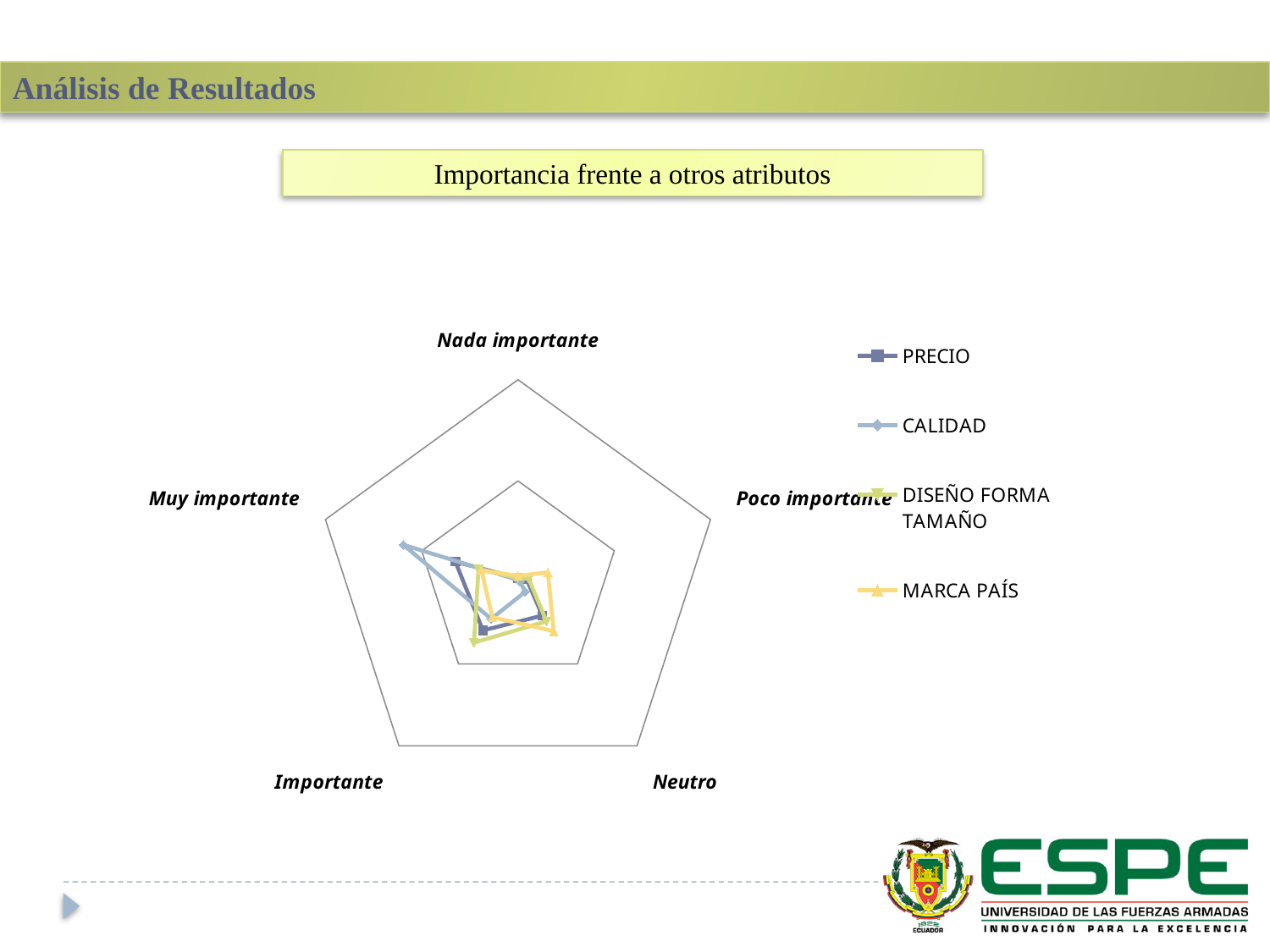
How many categories (axes) does the radar chart have? 5 What is the title shown above the radar chart? Importancia frente a otros atributos How many series does the legend of the radar chart list? 4 What kind of chart is shown on the slide? Radar chart Which series is listed first in the legend of the radar chart? PRECIO Which category label appears at the top of the radar chart? Nada importante Which series has the highest value on the 'Muy importante' axis of the radar chart? CALIDAD